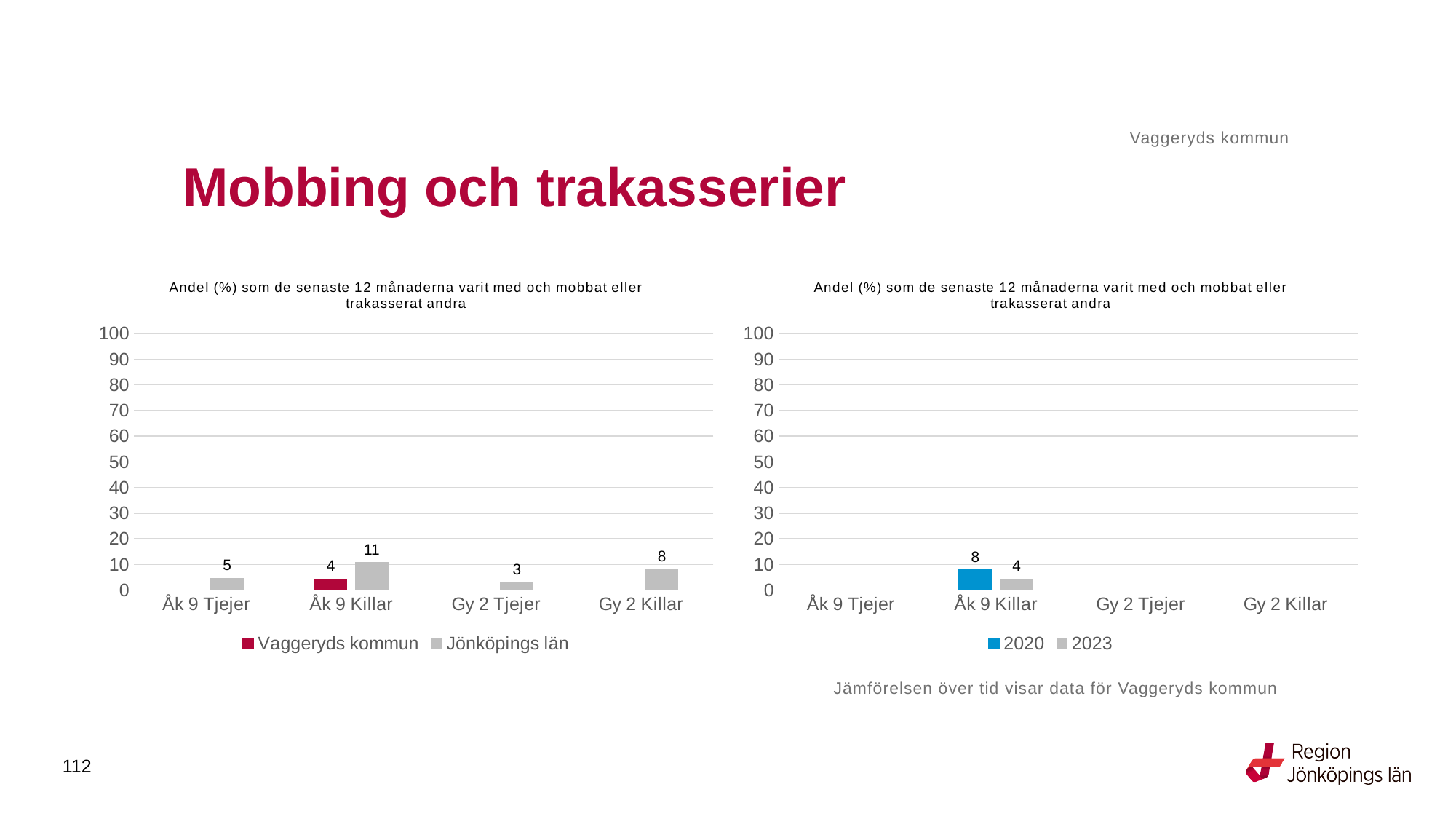
In the left chart, what is the value for Jönköpings län for Åk 9 Killar? 11 In the left chart, what is the value for Vaggeryds kommun for Åk 9 Killar? 4 In the right chart, what is the difference between the 2020 and 2023 values for Åk 9 Killar? 4 In the left chart, which is larger for Jönköpings län: Åk 9 Tjejer or Gy 2 Killar? Gy 2 Killar In the right chart, what is the value for 2023 for Åk 9 Killar? 4 In the left chart, what is the difference between Jönköpings län and Vaggeryds kommun for Åk 9 Killar? 7 In the right chart, what is the value for 2020 for Åk 9 Killar? 8 In the left chart, what is the value for Jönköpings län for Gy 2 Tjejer? 3 What type of chart is the left chart? Bar chart In the left chart, which category has the lowest value for Jönköpings län? Gy 2 Tjejer In the left chart, which category has the highest value for Jönköpings län? Åk 9 Killar How many series does the legend of the right chart list? 2